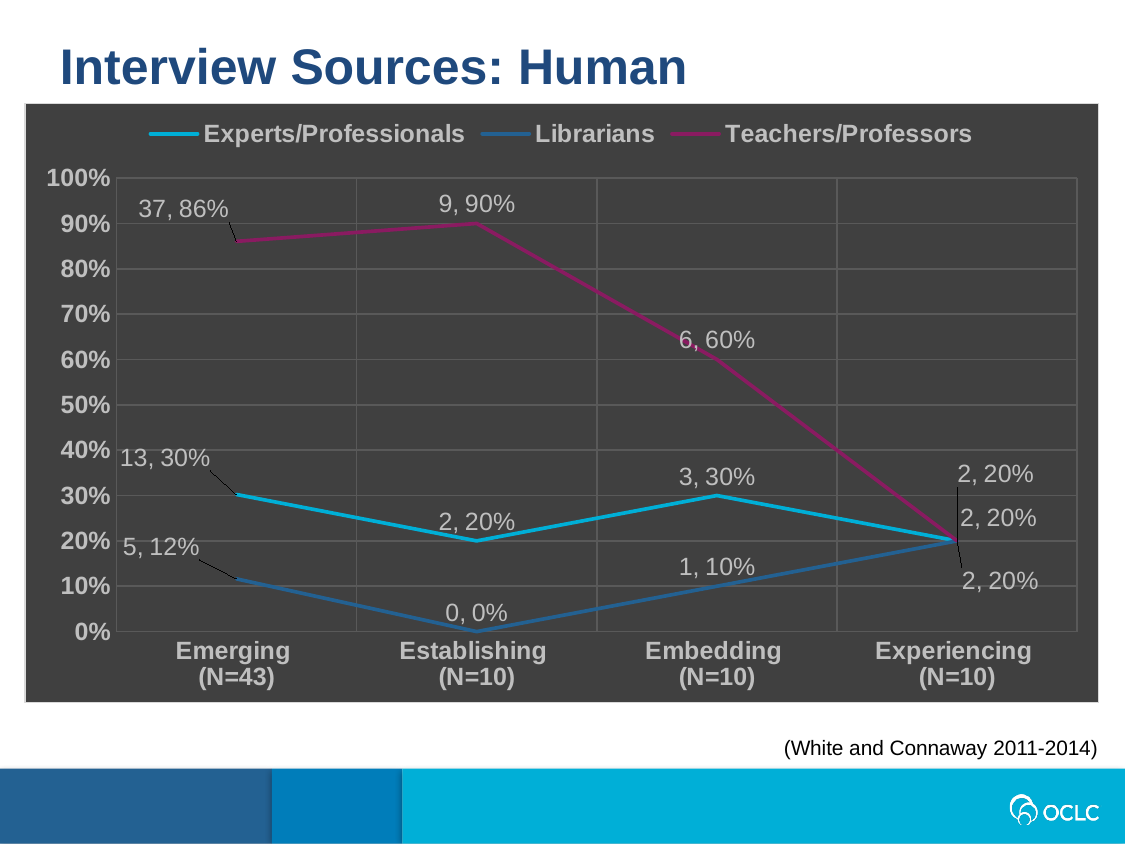
What is the title of the slide? Interview Sources: Human What is the difference in percentage points between Teachers/Professors and Experts/Professionals at Embedding (N=10)? 30 What percentage is shown for Librarians at Establishing (N=10)? 0% What percentage is shown for Experts/Professionals at Embedding (N=10)? 30% How many series does the legend list? 3 At which category does the Teachers/Professors series reach its highest value? Establishing (N=10) What type of chart is shown on the slide? line chart Which is larger at Emerging (N=43): the Experts/Professionals value or the Librarians value? Experts/Professionals How many categories are shown on the x axis? 4 What percentage is shown for Teachers/Professors at Emerging (N=43)? 86% Does the Teachers/Professors series rise or fall from Establishing (N=10) to Experiencing (N=10)? fall At which category does the Librarians series have its lowest value? Establishing (N=10)